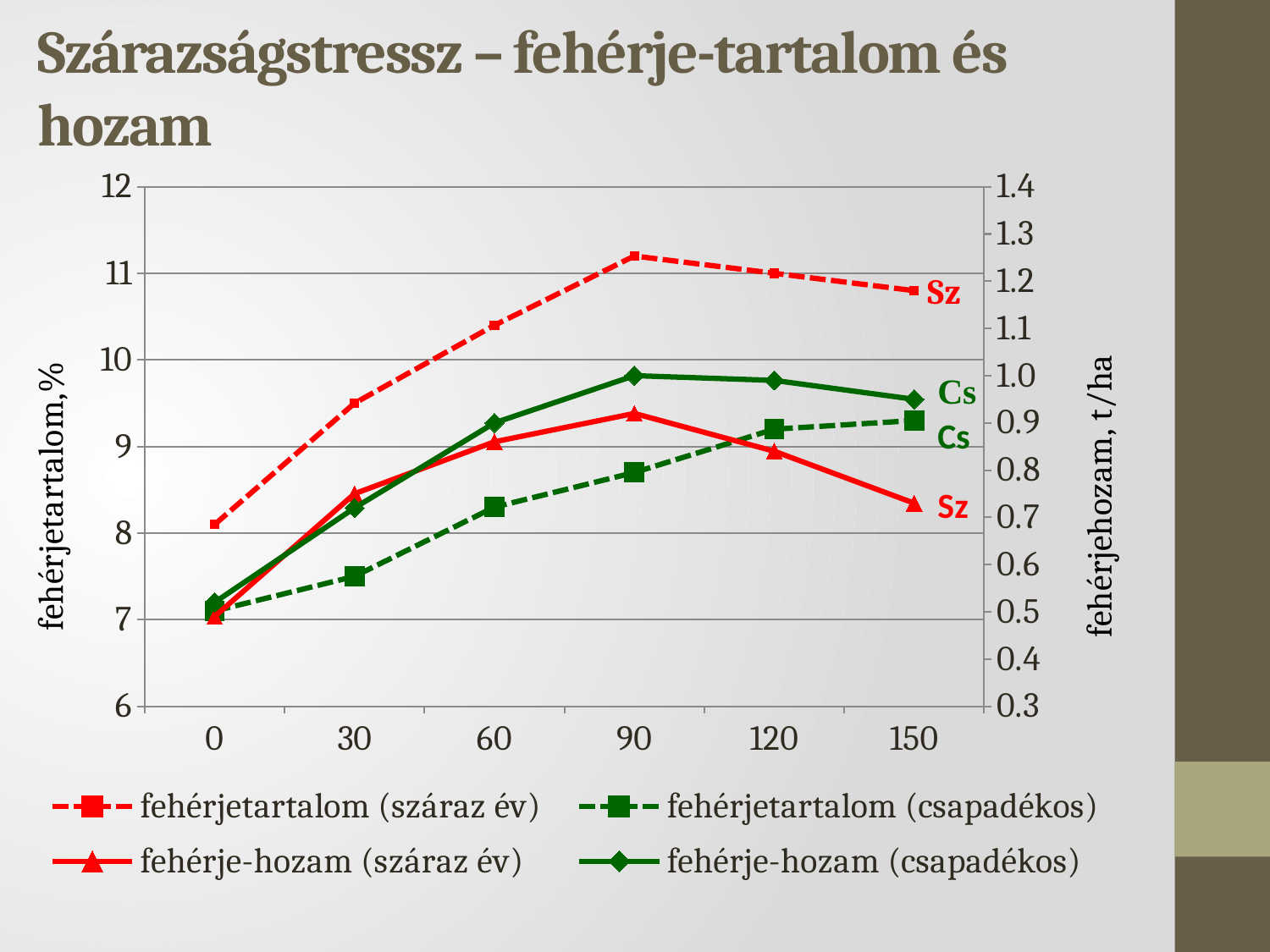
At which x-axis value is fehérjetartalom (csapadékos) lowest? 0 Is the value of fehérjetartalom (csapadékos) at 30 greater or less than 8? less Is the value of fehérjetartalom (száraz év) at 90 greater or less than 11? greater Is the value of fehérje-hozam (száraz év) at 150 greater or less than 0.8? less At which x-axis value does fehérjetartalom (száraz év) reach its highest point? 90 How many series does the legend list? 4 What is the title of the right-hand vertical axis? fehérjehozam, t/ha What kind of chart is shown on the slide? line chart How many points are plotted along the x axis for each series? 6 Does fehérjetartalom (csapadékos) rise or fall from 0 to 150 along the x axis? rise At 150, which is larger: fehérjetartalom (száraz év) or fehérjetartalom (csapadékos)? fehérjetartalom (száraz év)